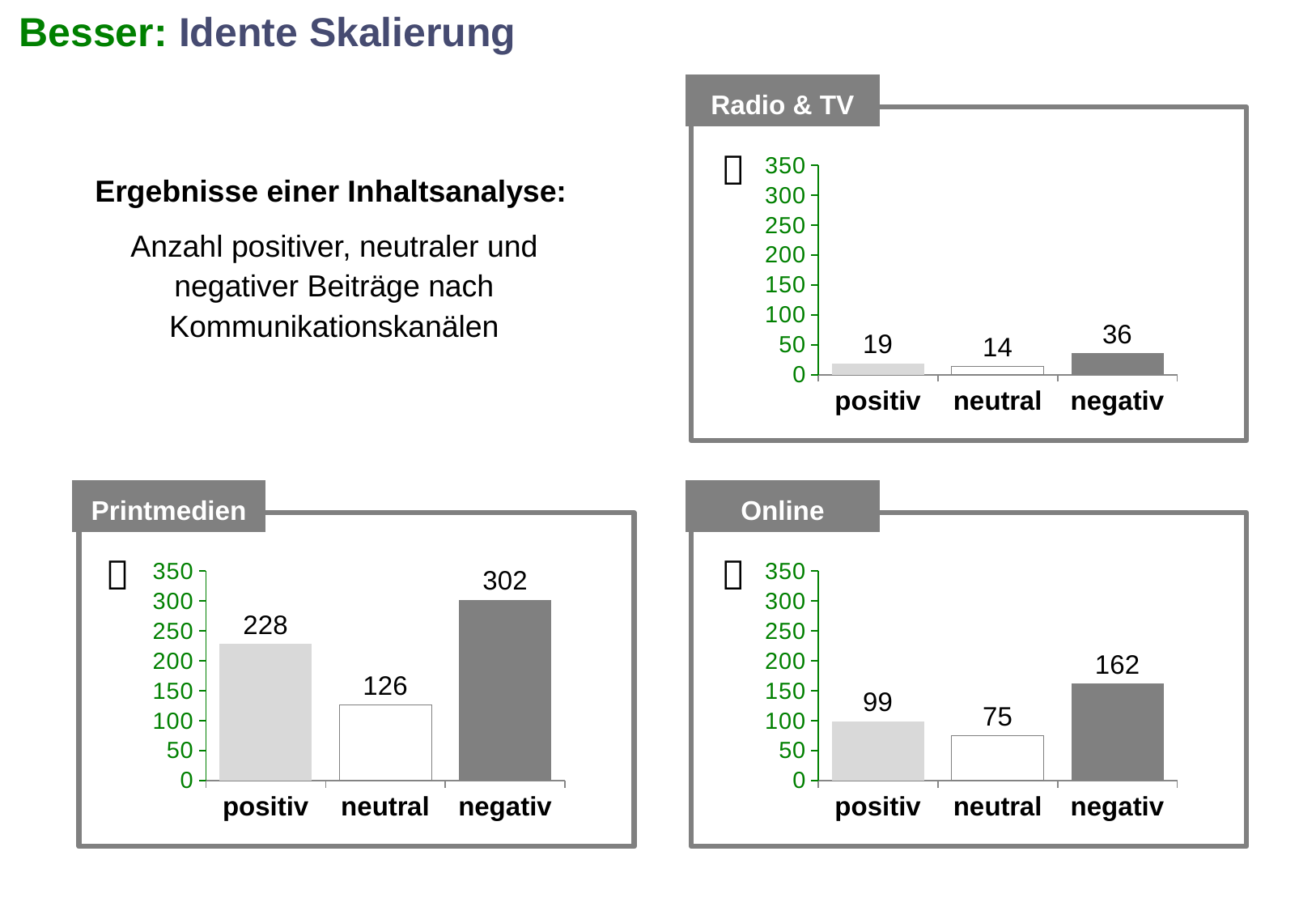
In the Radio & TV chart, what is the value for negativ? 36 In the Printmedien chart, what is the value for neutral? 126 In the Printmedien chart, is the value for positiv greater or less than 200? greater In the Online chart, what is the difference between negativ and neutral? 87 How many categories does the Radio & TV chart show? 3 In the Radio & TV chart, which category has the lowest value? neutral In the Printmedien chart, which category has the highest value? negativ In the Printmedien chart, what is the difference between negativ and positiv? 74 What is the maximum value shown on the y axis of the Printmedien chart? 350 In the Online chart, which is larger, positiv or neutral? positiv In the Online chart, what is the value for positiv? 99 What kind of chart is the Online chart? bar chart